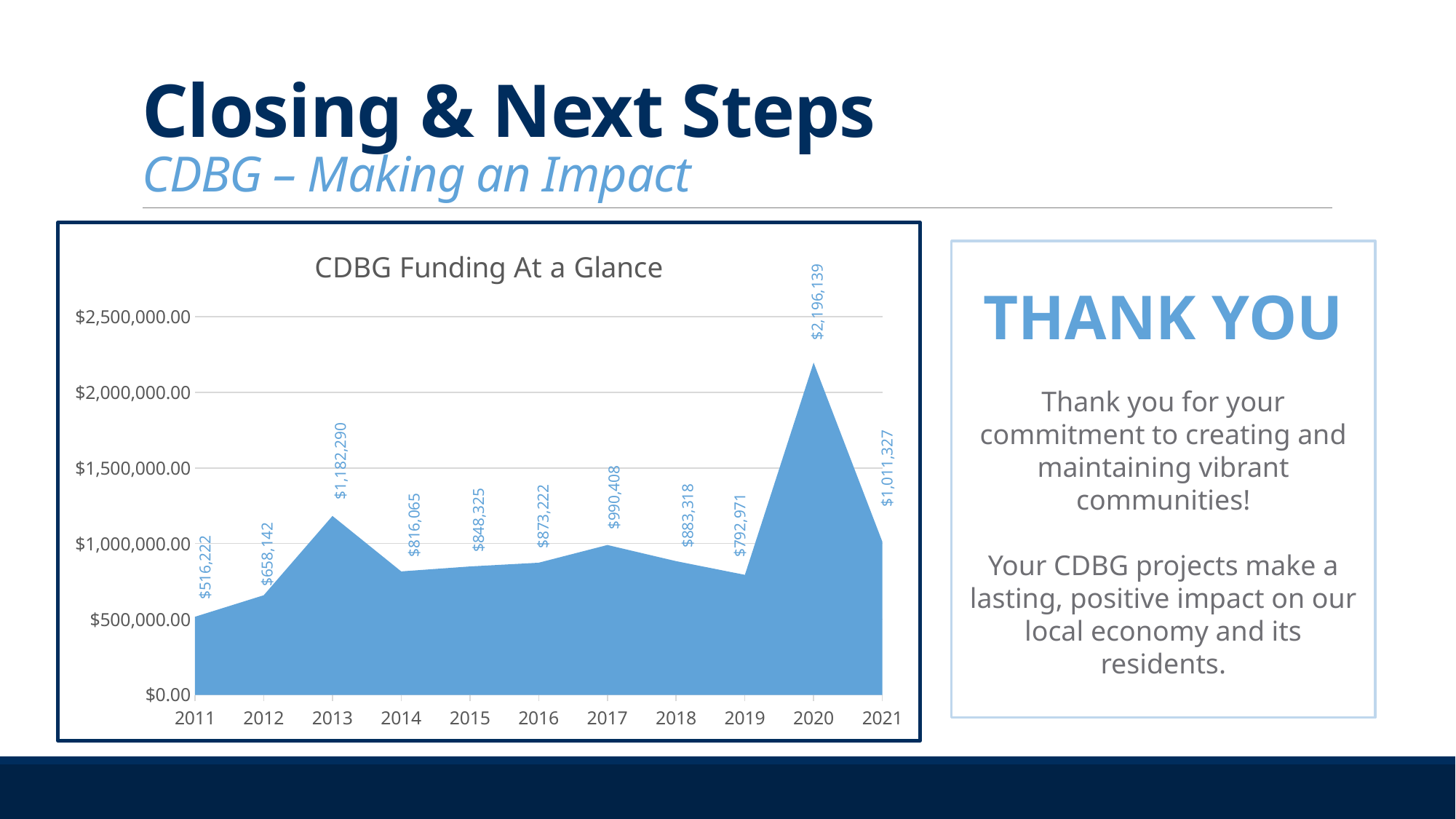
What is the title of the chart? CDBG Funding At a Glance What is the difference in CDBG funding between 2020 and 2019? $1,403,168 What is the CDBG funding value for 2017? $990,408 What is the CDBG funding value for 2011? $516,222 What is the difference in CDBG funding between 2013 and 2012? $524,148 Which year had higher CDBG funding, 2013 or 2021? 2013 Which year has the highest CDBG funding? 2020 How many years are shown on the x axis of the chart? 11 What kind of chart is used to show CDBG funding? area chart Which year has the lowest CDBG funding? 2011 Is the CDBG funding value for 2017 greater or less than $1,000,000.00? less What is the CDBG funding value for 2020? $2,196,139